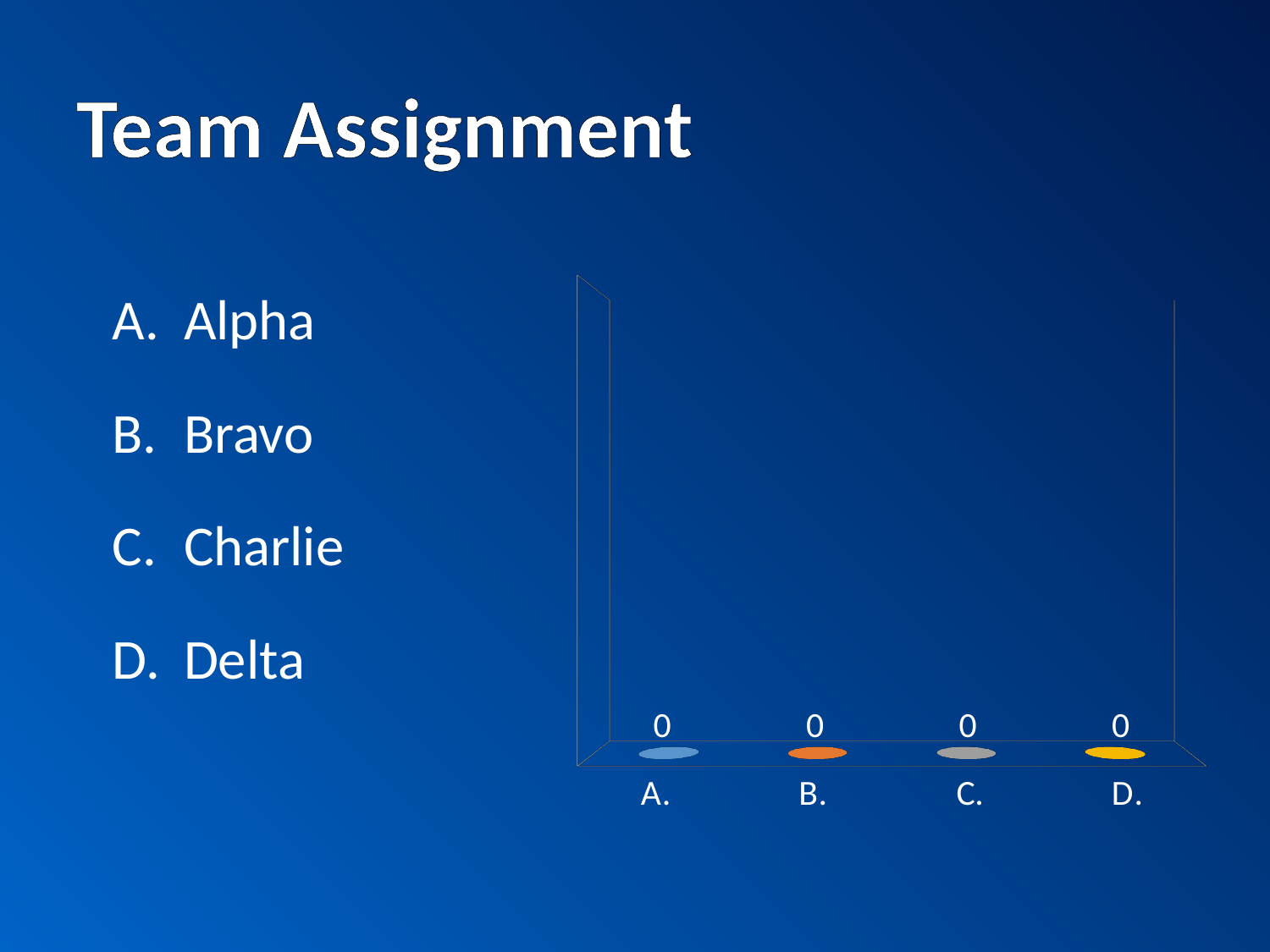
How many categories are shown on the x axis of the chart? 4 What are the category labels along the x axis of the chart? A., B., C., D. What is the value for category C. in the chart? 0 What colour is the marker for category B. in the chart? Orange Do the values rise, fall, or stay flat from A. to D.? Stay flat What is the value for category D. in the chart? 0 What is the difference between the values for A. and D.? 0 What kind of chart is shown on the slide? Bar chart What is the value for category A. in the chart? 0 What is the value for category B. in the chart? 0